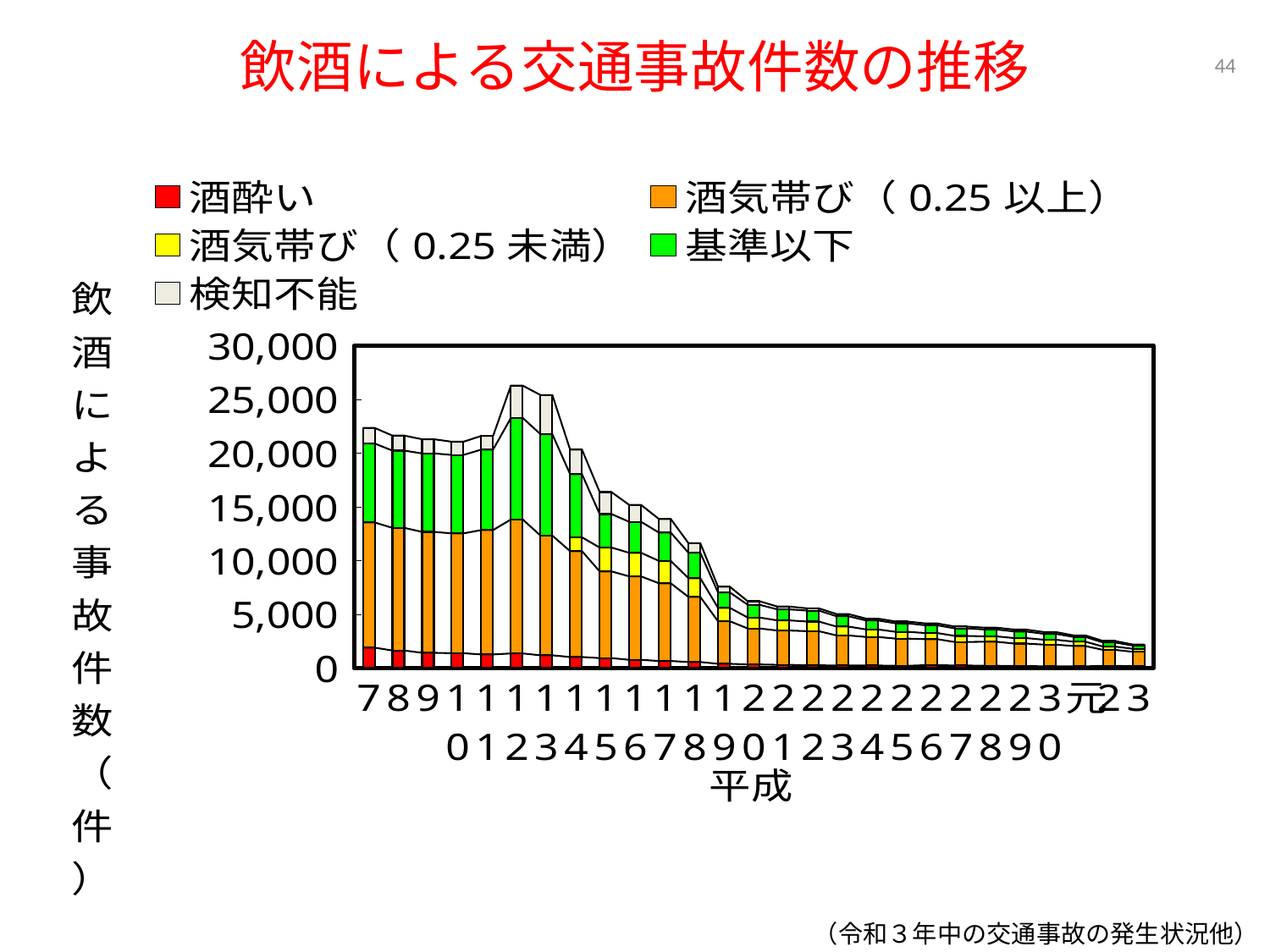
Which year has the shortest stacked bar? 令和3 What kind of chart is shown on the slide? stacked bar chart Is the total for 平成20 greater or less than 10,000? less Which year has the tallest stacked bar? 平成12 How many series does the legend list? 5 From 平成12 onward, do the totals rise or fall along the x axis? fall Is the total for 平成12 greater or less than 25,000? greater Is the total for 令和3 greater or less than 5,000? less Which is larger, the total for 平成7 or the total for 令和3? 平成7 What is the title of the chart? 飲酒による交通事故件数の推移 Which colour represents 酒酔い in the legend? red